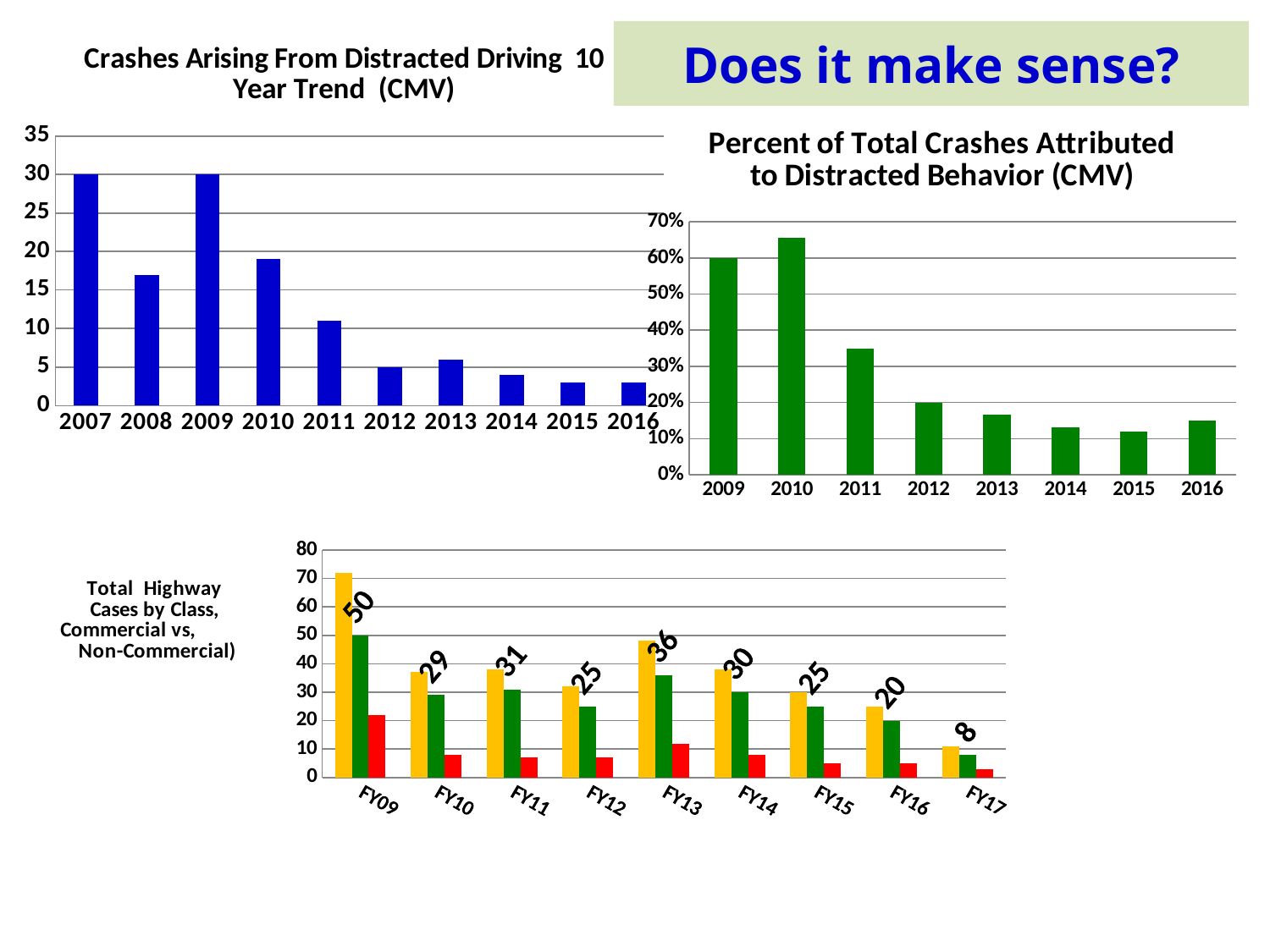
In the 'Total Highway Cases by Class' chart at the bottom, what is the difference between the labelled green-bar values for FY09 and FY17? 42 In the 'Total Highway Cases by Class' chart at the bottom, what is the data label on the green bar for FY09? 50 In the 'Crashes Arising From Distracted Driving 10 Year Trend (CMV)' chart, is the value for 2008 greater or less than 15? greater In the 'Percent of Total Crashes Attributed to Distracted Behavior (CMV)' chart, which year has the highest value? 2010 In the 'Total Highway Cases by Class' chart at the bottom, how many fiscal years are shown on the x axis? 9 In the 'Crashes Arising From Distracted Driving 10 Year Trend (CMV)' chart, do the values generally rise or fall from 2007 to 2016? fall In the 'Crashes Arising From Distracted Driving 10 Year Trend (CMV)' chart, what is the value for 2007? 30 What kind of chart is the 'Crashes Arising From Distracted Driving 10 Year Trend (CMV)' chart? bar chart In the 'Crashes Arising From Distracted Driving 10 Year Trend (CMV)' chart, how many years are shown on the x axis? 10 In the 'Percent of Total Crashes Attributed to Distracted Behavior (CMV)' chart, what is the value for 2009? 60% In the 'Percent of Total Crashes Attributed to Distracted Behavior (CMV)' chart, is the value for 2011 greater or less than 30%? greater In the 'Crashes Arising From Distracted Driving 10 Year Trend (CMV)' chart, what is the value for 2012? 5